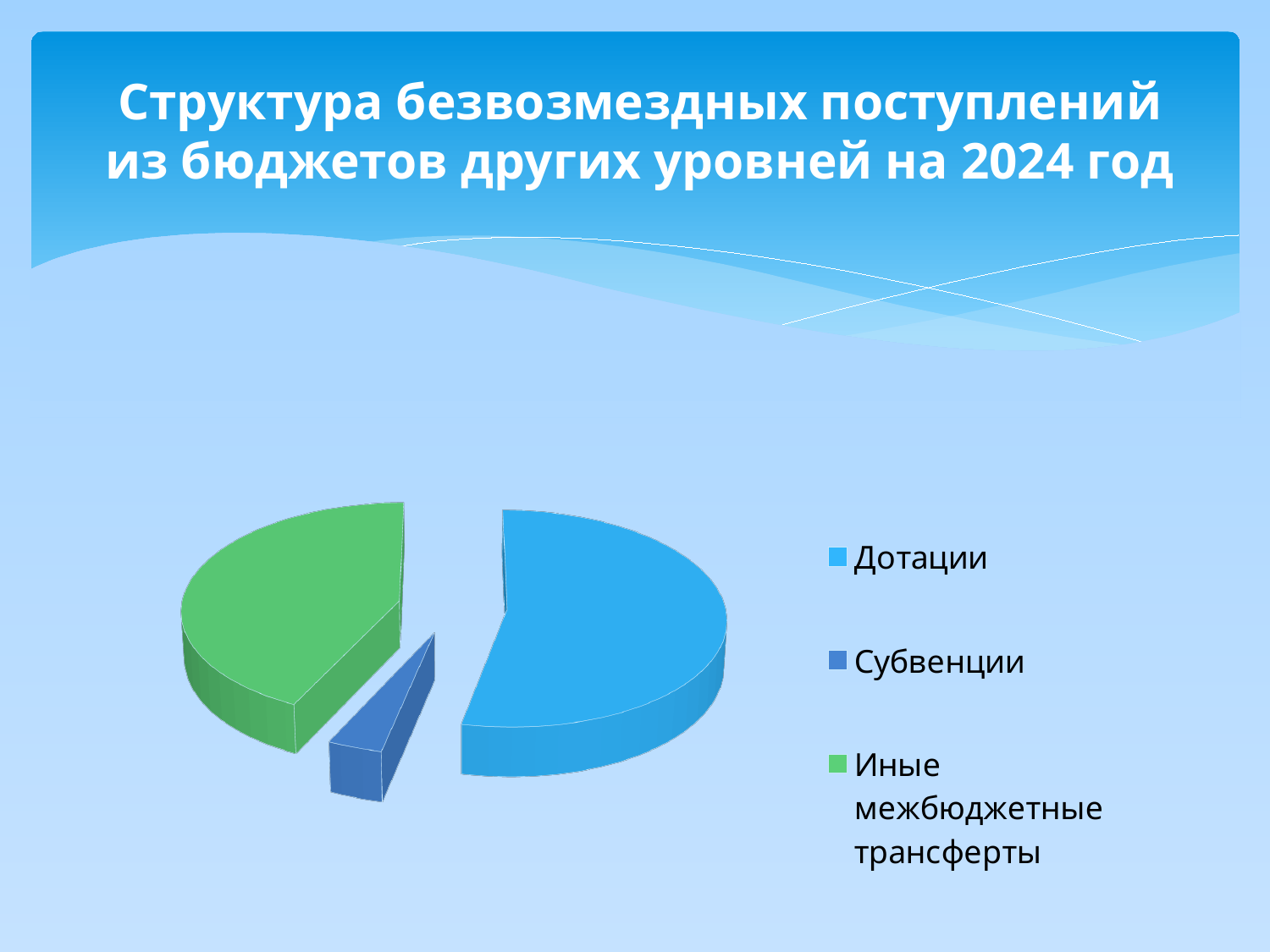
Which slice is larger: Дотации or Иные межбюджетные трансферты? Дотации What kind of chart is shown on the slide? Pie chart Which category has the largest slice of the pie? Дотации How many slices does the pie chart have? 3 Which slice is larger: Субвенции or Иные межбюджетные трансферты? Иные межбюджетные трансферты What is the title of the slide? Структура безвозмездных поступлений из бюджетов других уровней на 2024 год Which slice is larger: Дотации or Субвенции? Дотации Which category has the smallest slice of the pie? Субвенции How many entries does the legend list? 3 What colour is the slice for Иные межбюджетные трансферты? Green